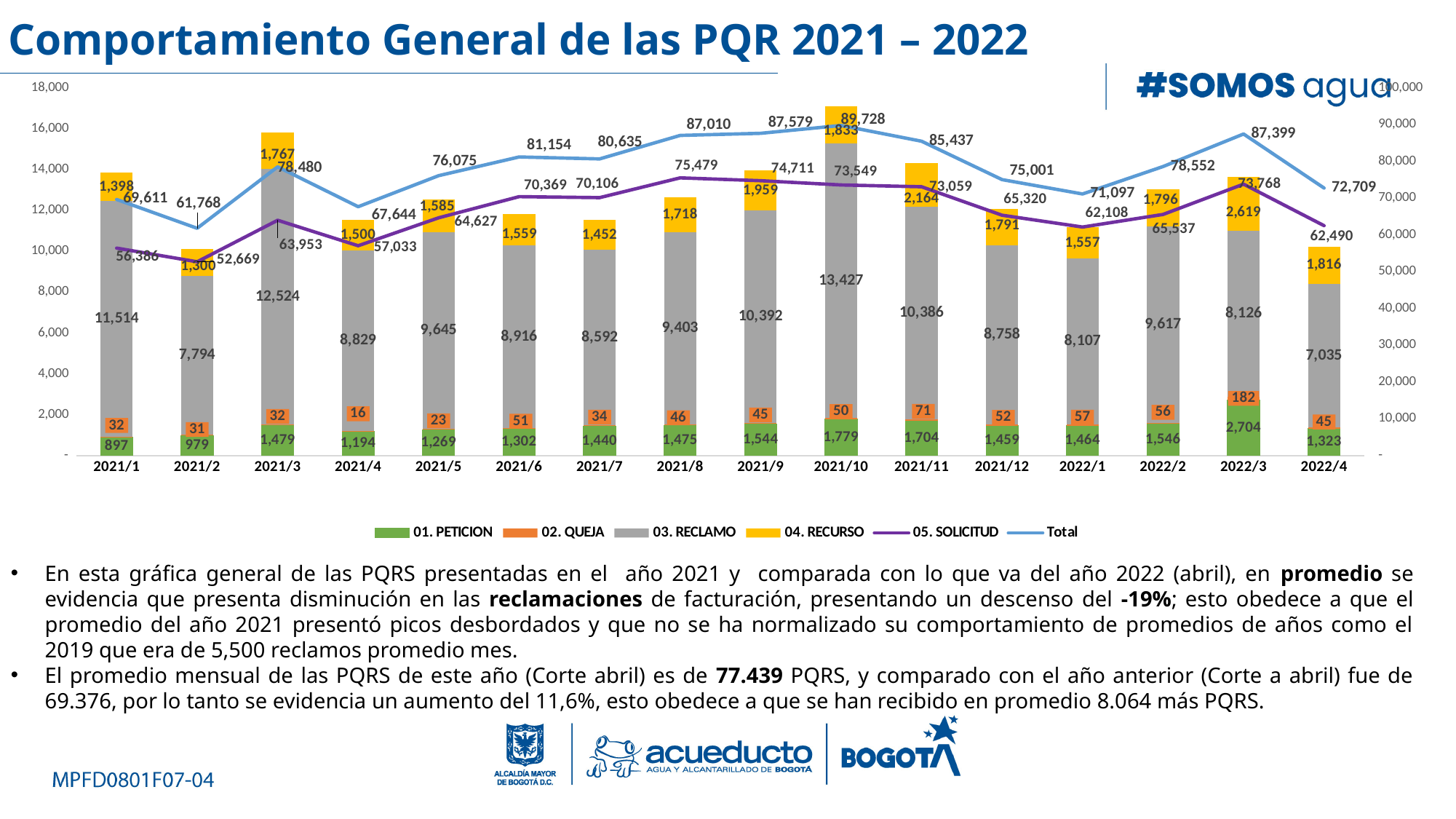
Which is larger, the 01. PETICION value for 2022/3 or for 2021/10? 2022/3 What kind of chart is shown on the slide? Combined stacked bar and line chart Which period has the highest Total value? 2021/10 How many series does the legend list? 6 What is the value of 05. SOLICITUD for 2021/8? 75,479 Which period has the lowest 03. RECLAMO value? 2022/4 What is the difference between the 03. RECLAMO values for 2021/10 and 2022/4? 6,392 What is the value of 03. RECLAMO for 2021/10? 13,427 Which period has the lowest Total value? 2021/2 What is the value of 02. QUEJA for 2022/3? 182 What is the Total value for 2022/4? 72,709 How many periods are shown on the x axis? 16